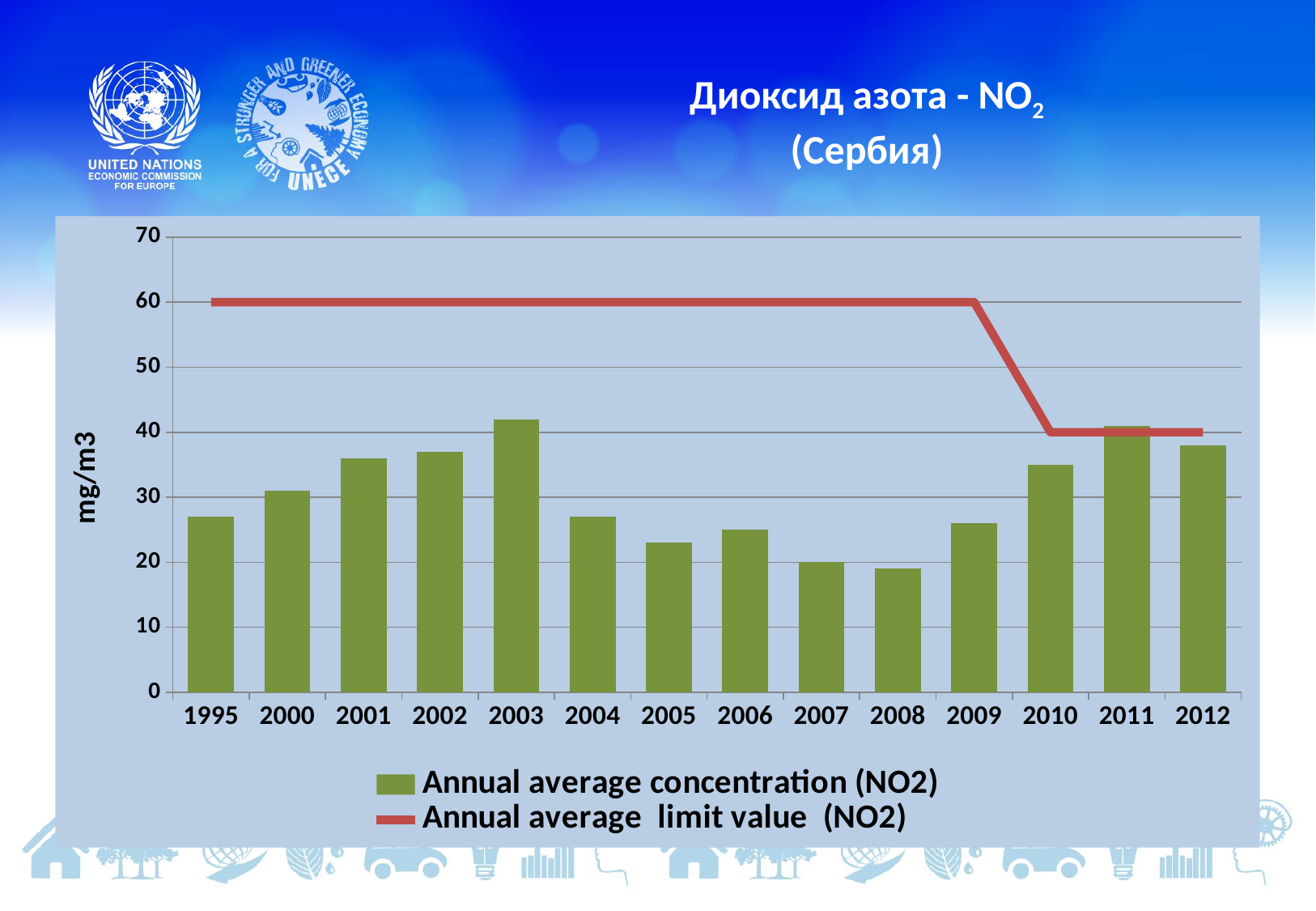
Which year has the lowest annual average concentration (NO2)? 2008 How many series does the legend list? 2 What kind of chart is shown on the slide? bar chart with a line What is the annual average limit value (NO2) in 2012? 40 Which year has the highest annual average concentration (NO2)? 2003 What is the annual average limit value (NO2) in 1995? 60 What unit is shown on the y axis? mg/m3 Is the annual average concentration (NO2) for 1995 greater or less than 30? less Is the annual average concentration (NO2) for 2003 greater or less than 40? greater Which year has the larger annual average concentration (NO2), 2001 or 2004? 2001 How many years are shown on the x axis? 14